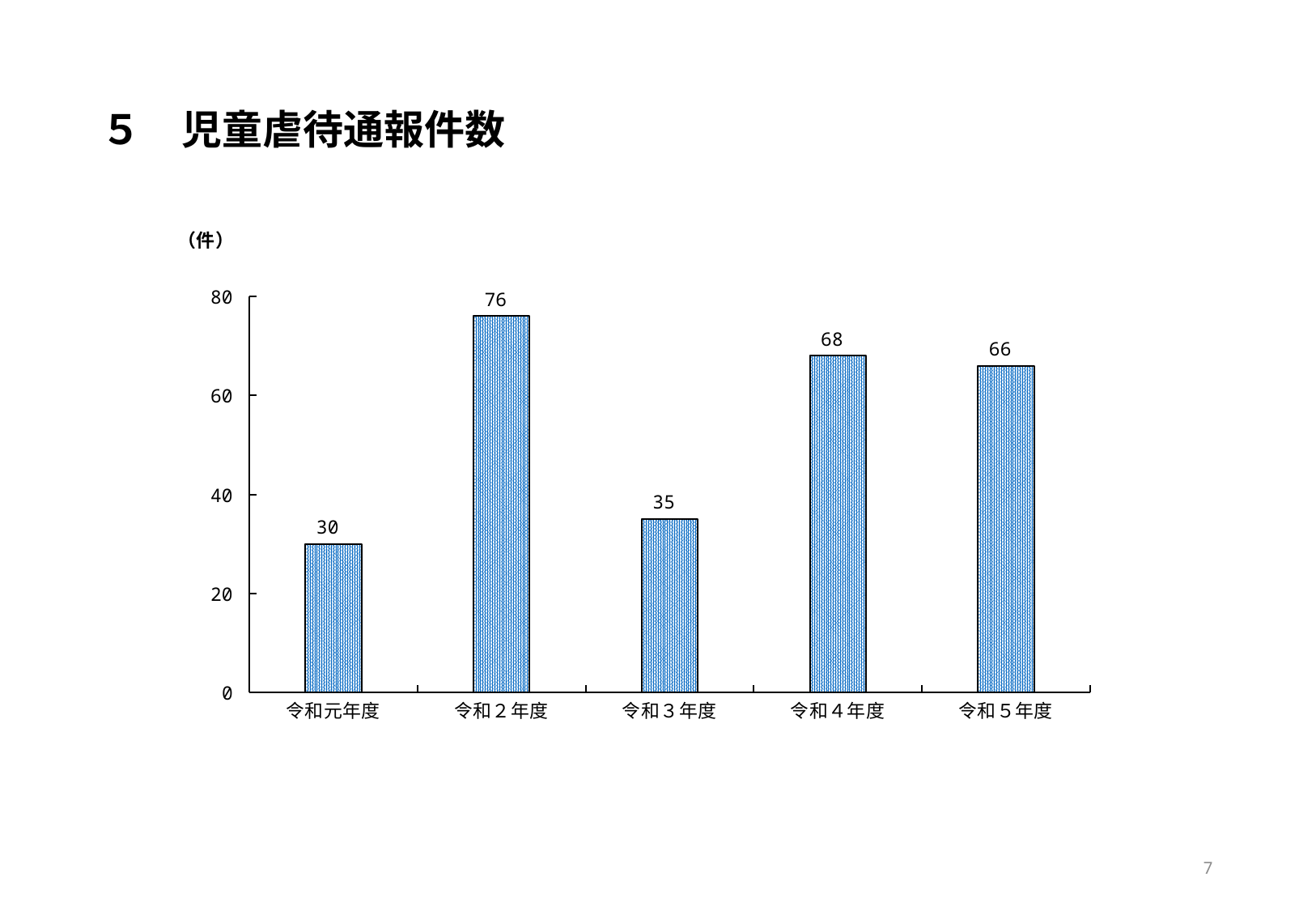
What kind of chart is shown on the slide? bar chart What is the value for 令和５年度? 66 What is the difference between the values for 令和２年度 and 令和３年度? 41 What unit is indicated above the y axis? （件） Which is larger, the value for 令和３年度 or the value for 令和４年度? 令和４年度 What is the difference between the values for 令和４年度 and 令和５年度? 2 Which fiscal year has the highest number of reports? 令和２年度 What is the value for 令和２年度? 76 Which fiscal year has the lowest number of reports? 令和元年度 How many fiscal years are shown on the x axis? 5 Is the value for 令和３年度 greater or less than 40? less What is the value for 令和元年度? 30